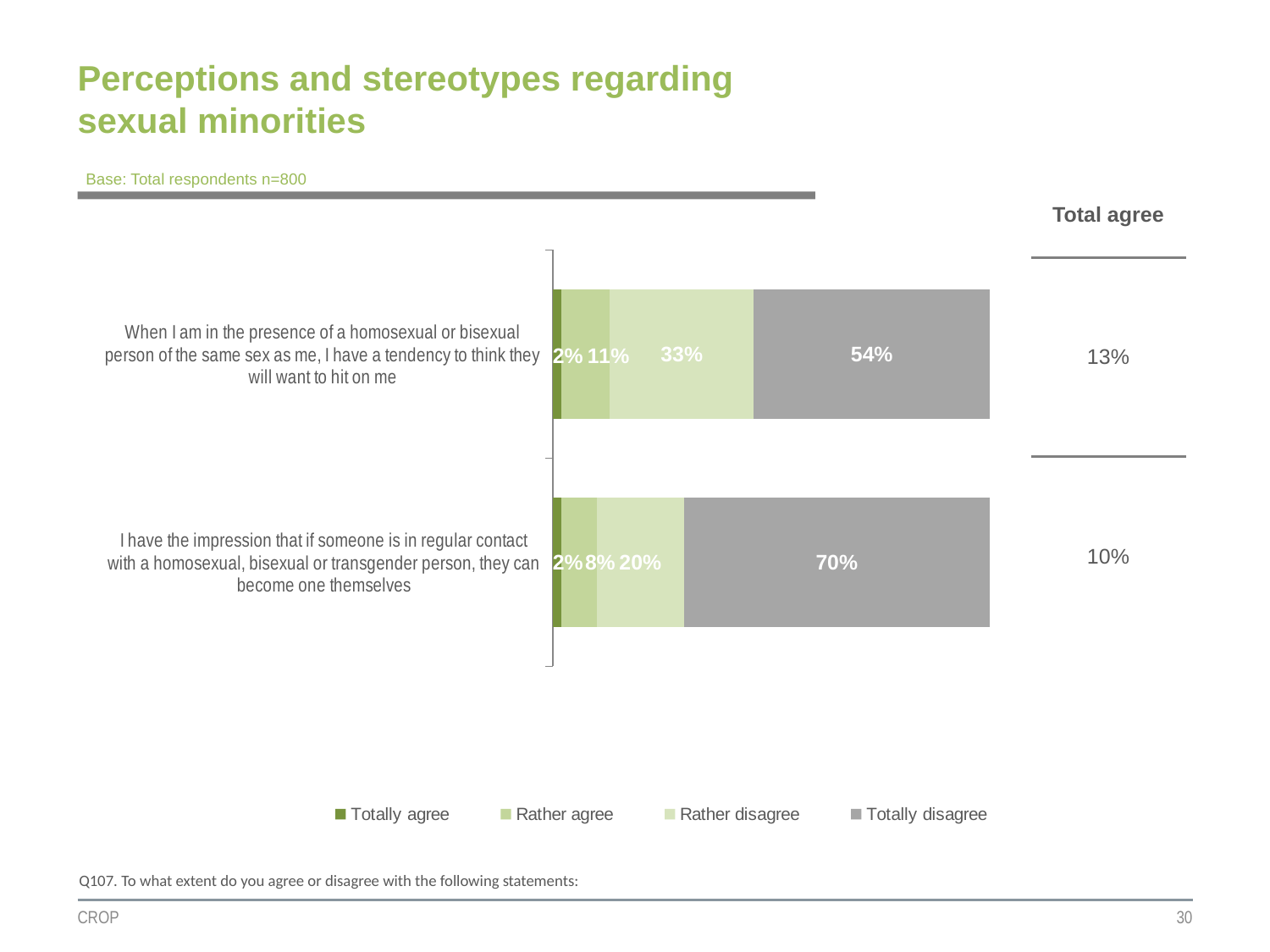
What percentage of respondents rather disagree with the statement that someone in regular contact with a homosexual, bisexual or transgender person can become one themselves? 20% What percentage of respondents totally disagree with the statement that someone in regular contact with a homosexual, bisexual or transgender person can become one themselves? 70% Which statement has the higher 'Totally disagree' percentage? I have the impression that if someone is in regular contact with a homosexual, bisexual or transgender person, they can become one themselves What is the difference between the 'Totally disagree' percentages of the two statements? 16 percentage points What type of chart is shown on the slide? Stacked bar chart What percentage of respondents rather agree with the statement about thinking a homosexual or bisexual person of the same sex will want to hit on them? 11% What is the 'Total agree' figure for the statement about thinking a homosexual or bisexual person of the same sex will want to hit on them? 13% What is the 'Total agree' figure for the statement that someone in regular contact with a homosexual, bisexual or transgender person can become one themselves? 10% How many statements are shown in the chart? 2 Is the 'Rather disagree' share larger for the 'hit on me' statement or the 'become one themselves' statement? The 'hit on me' statement How many response categories does the legend list? 4 What percentage of respondents totally disagree with the statement that a homosexual or bisexual person of the same sex will want to hit on them? 54%